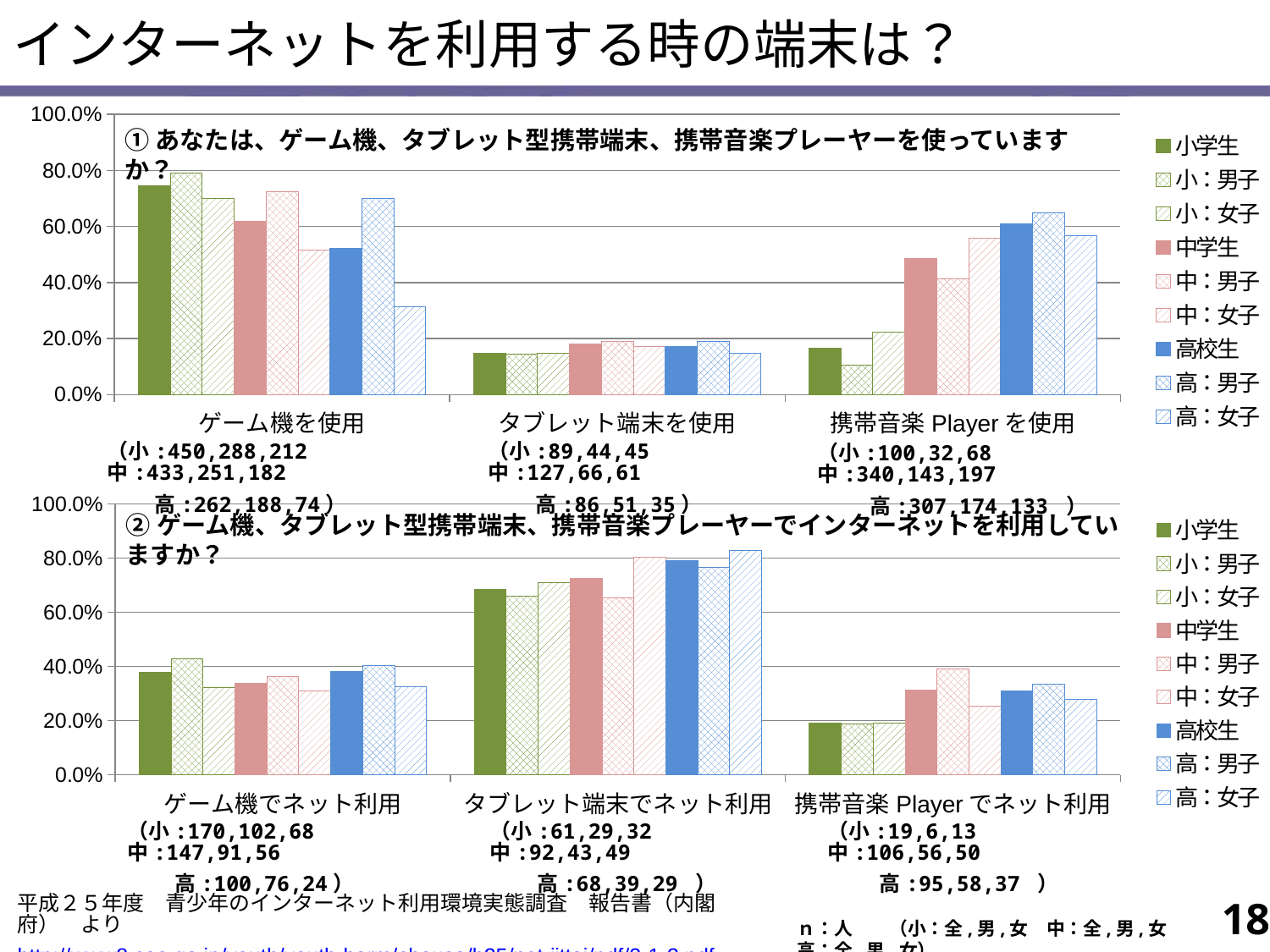
In the bottom chart (②), in which category is the 高校生 series lowest? 携帯音楽 Player でネット利用 What kind of chart is the top chart (①)? bar chart In the top chart (①), is the value for 高：女子 in ゲーム機を使用 greater or less than 40.0%? less In the bottom chart (②), for 携帯音楽 Player でネット利用, which is larger: 小学生 or 中学生? 中学生 In the bottom chart (②), is the value for 中：女子 in タブレット端末でネット利用 greater or less than 60.0%? greater In the bottom chart (②), is the value for 小学生 in 携帯音楽 Player でネット利用 greater or less than 40.0%? less In the top chart (①), in which category is the 小学生 series highest? ゲーム機を使用 In the top chart (①), for 携帯音楽 Player を使用, which is larger: 小学生 or 高校生? 高校生 What is the highest tick value shown on the y axis of the top chart (①)? 100.0% How many series does the legend of the top chart (①) list? 9 How many categories are shown on the x axis of the bottom chart (②)? 3